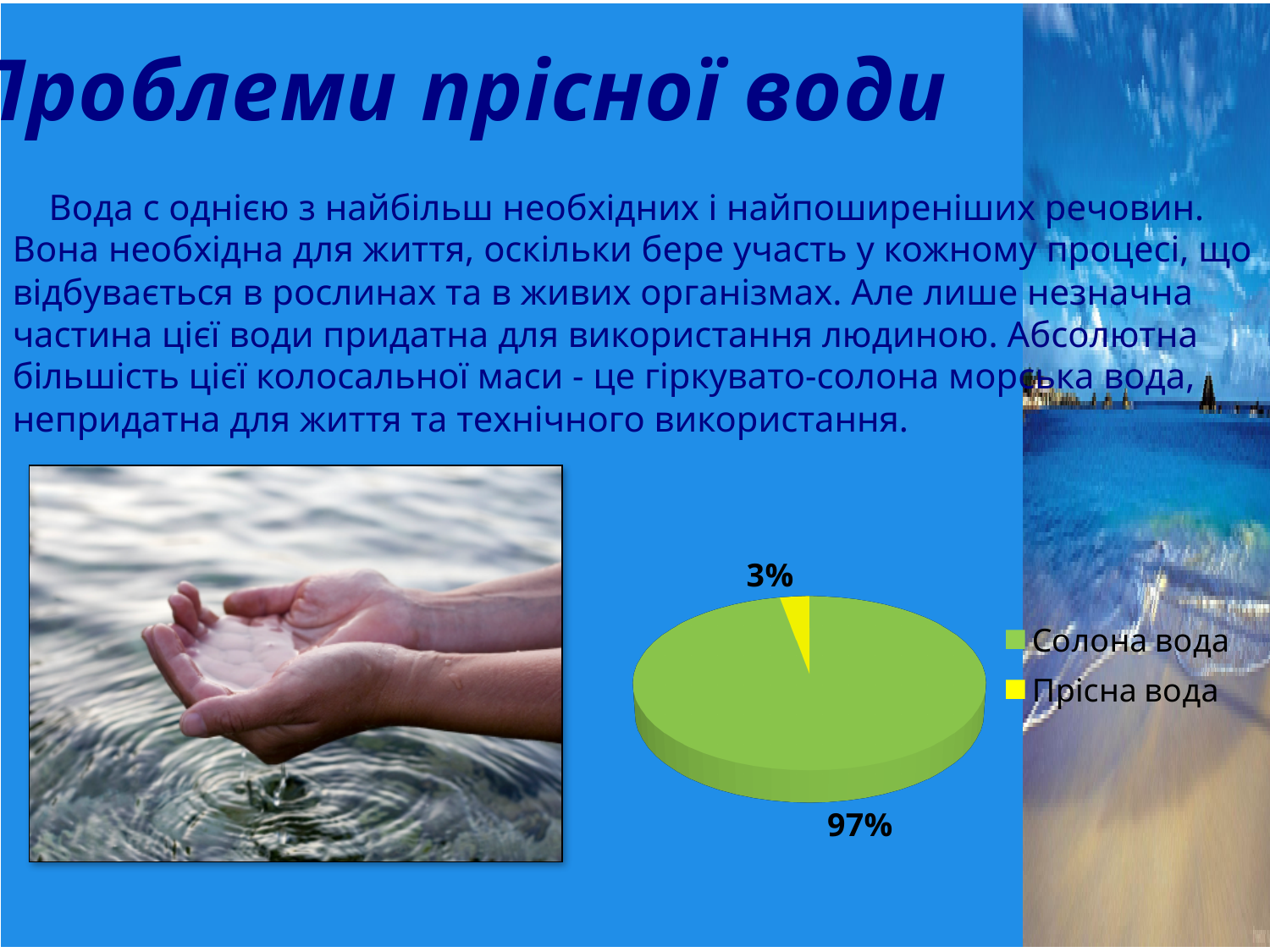
How many categories does the pie chart show? 2 What colour is the slice for Солона вода? green What kind of chart is shown on the slide? pie chart How many entries does the legend list? 2 What colour is the slice for Прісна вода? yellow Which is larger, the share of Солона вода or the share of Прісна вода? Солона вода What share of the pie does Солона вода take? 97% Which category has the smallest slice of the pie? Прісна вода What share of the pie does Прісна вода take? 3% What is the difference between the shares of Солона вода and Прісна вода? 94% Which category has the largest slice of the pie? Солона вода